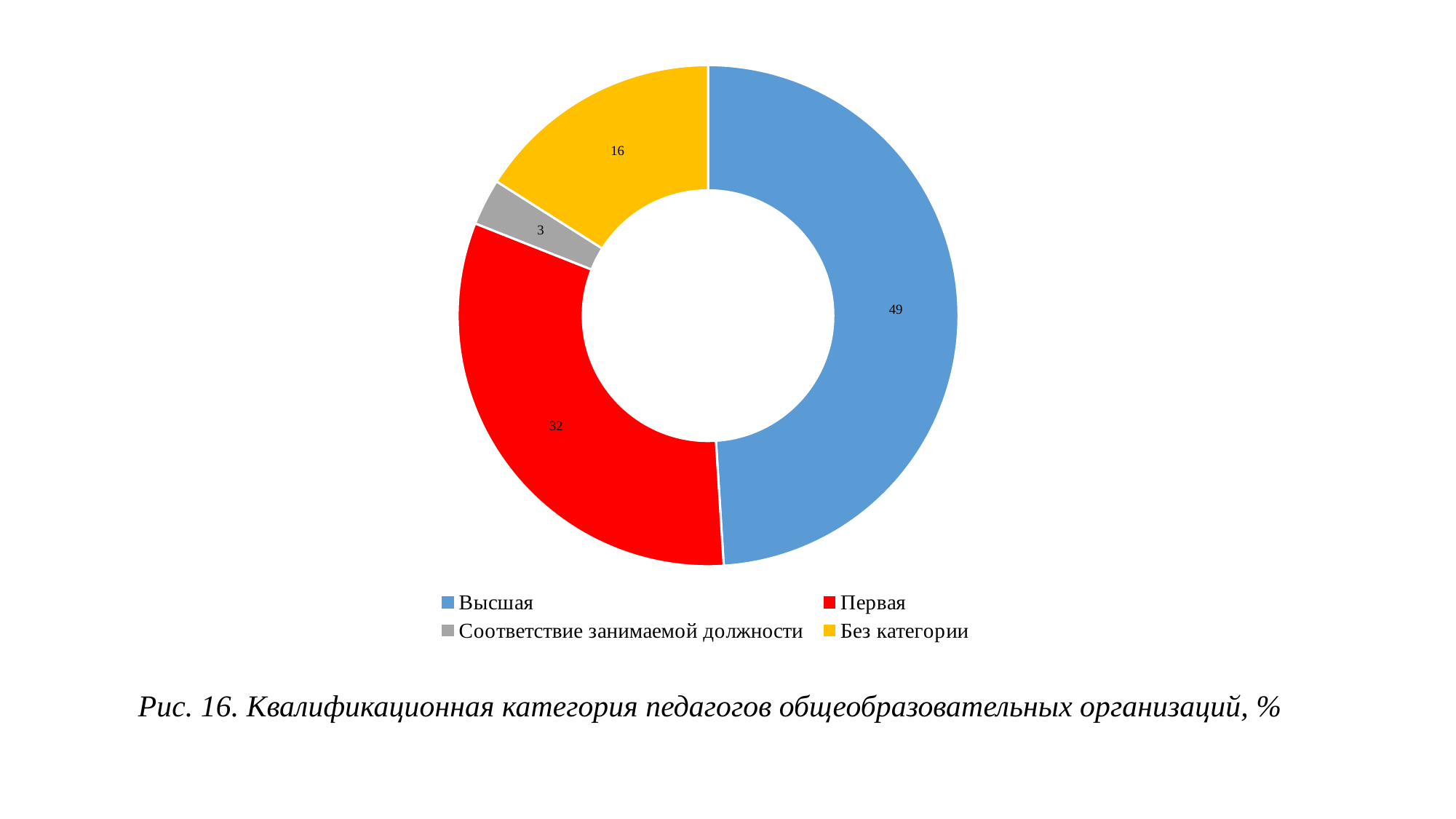
How many categories does the chart show? 4 What kind of chart is shown on the slide? Doughnut (pie) chart What value is shown for the Первая slice? 32 What colour is the Первая slice? Red Which category has the smallest slice? Соответствие занимаемой должности What value is shown for the Без категории slice? 16 Which category has the largest slice? Высшая Which is larger, the value for Без категории or the value for Соответствие занимаемой должности? Без категории What value is shown for the Соответствие занимаемой должности slice? 3 What value is shown for the Высшая slice? 49 What is the caption of the figure? Рис. 16. Квалификационная категория педагогов общеобразовательных организаций, % What is the difference between the values for Высшая and Первая? 17